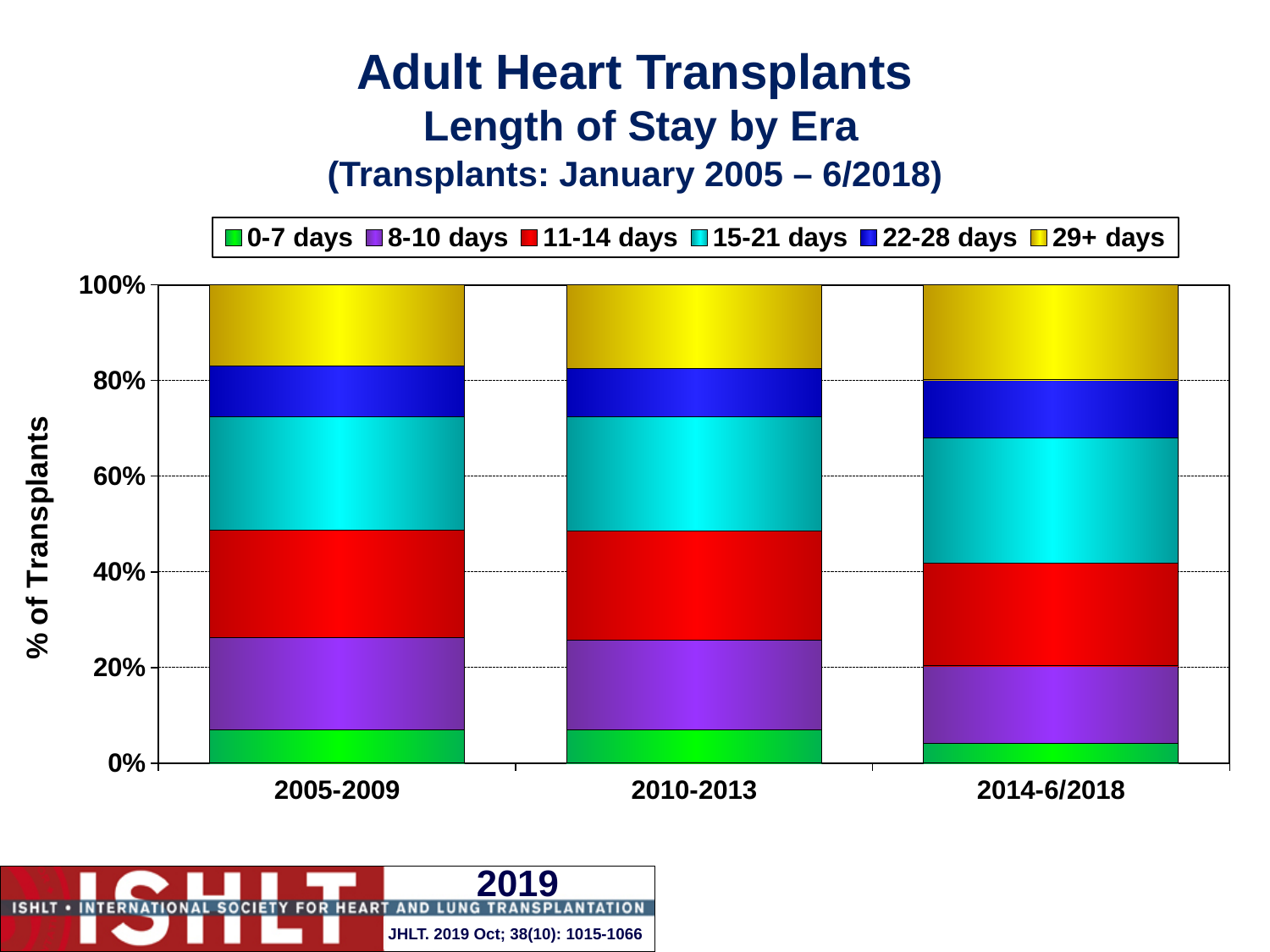
Which length-of-stay category is shown in green in the legend? 0-7 days What is the label of the y axis? % of Transplants Is the cumulative top of the 11-14 days segment in the 2005-2009 bar greater or less than 40%? greater Is the cumulative top of the 15-21 days segment in the 2014-6/2018 bar greater or less than 60%? greater How many eras (categories) are shown on the x axis? 3 Is the 0-7 days share larger in 2005-2009 or in 2014-6/2018? 2005-2009 Is the cumulative top of the 22-28 days segment in the 2005-2009 bar greater or less than 80%? greater What is the total of the stacked bar for 2005-2009? 100% Which era has the smallest 0-7 days share? 2014-6/2018 How many series does the legend list? 6 What kind of chart is shown on the slide? Stacked bar chart